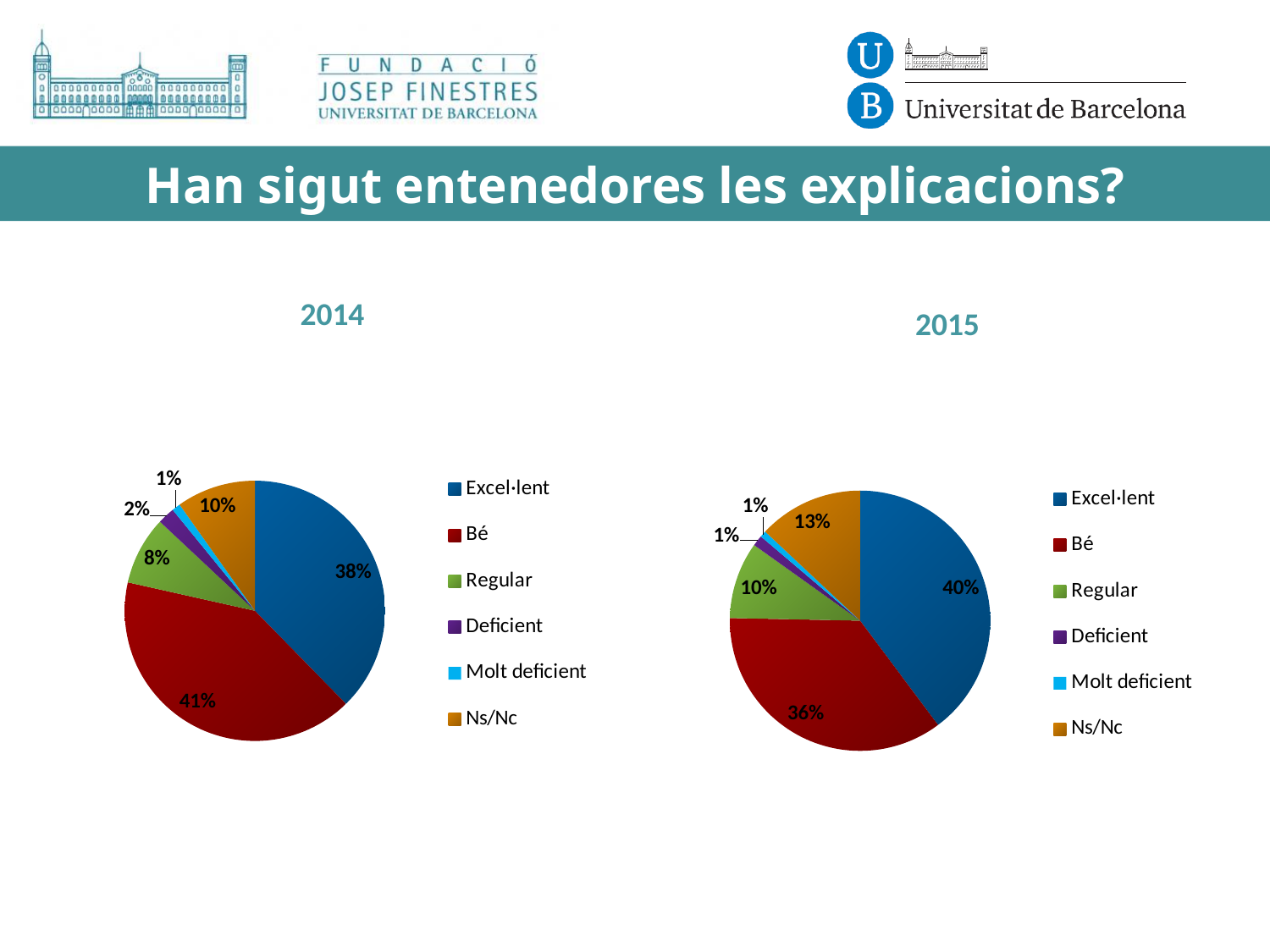
In the 2015 chart, what percentage is shown for Regular? 10% How many categories does the legend of the 2015 chart list? 6 In the 2014 chart, which category has the largest share? Bé In the 2014 chart, which is larger, the share for Regular or the share for Ns/Nc? Ns/Nc In the 2015 chart, what colour represents Ns/Nc? Orange In the 2015 chart, what is the difference in percentage points between Excel·lent and Bé? 4 In the 2014 chart, what percentage is shown for Ns/Nc? 10% In the 2014 chart, which category has the smallest share? Molt deficient In the 2015 chart, which category has the largest share? Excel·lent What type of chart is used for the 2014 data? Pie chart In the 2015 chart, what percentage is shown for Excel·lent? 40% In the 2014 chart, what percentage is shown for Bé? 41%